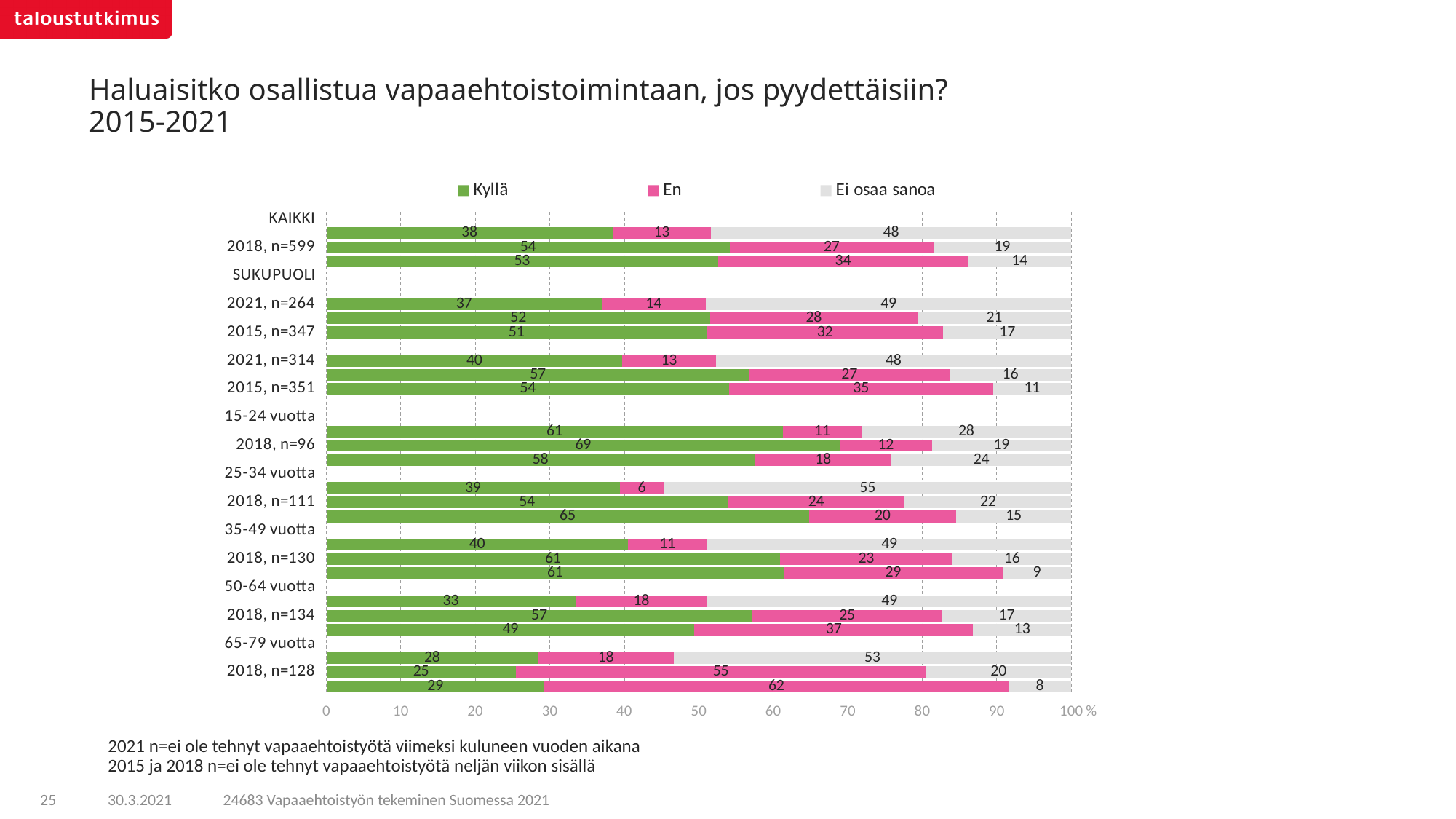
Is the En value for the bar labelled 2018, n=128 greater or less than 50? greater What kind of chart is shown on the slide? Stacked bar chart What is the total of the stacked bar labelled 2018, n=130? 100 What is the Kyllä value for the bar labelled 2018, n=599? 54 Among the bars labelled with a year and n, which has the lowest Kyllä value? 2018, n=128 What is the En value for the bar labelled 2018, n=128? 55 What is the Ei osaa sanoa value for the bar labelled 2021, n=264? 49 What is the Kyllä value for the bar labelled 2015, n=351? 54 Which colour represents the Kyllä series in the legend? Green Which has the larger Kyllä value: the bar labelled 2018, n=96 or the bar labelled 2018, n=134? 2018, n=96 What is the difference between the En value for 2015, n=351 and the En value for 2021, n=314? 22 How many series does the legend list? 3